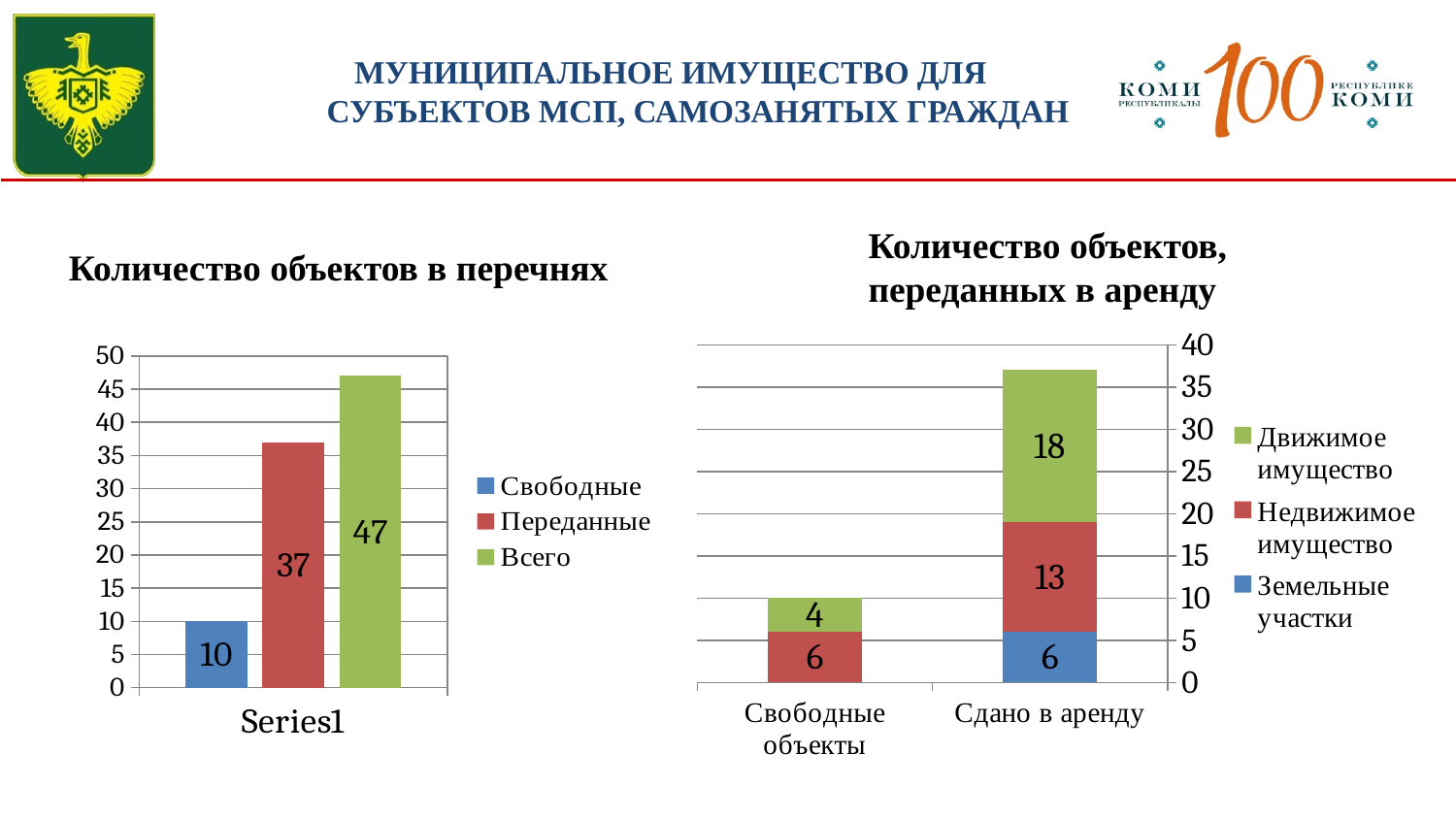
What kind of chart is 'Количество объектов в перечнях'? Bar chart In the chart 'Количество объектов в перечнях', how many series does the legend list? 3 In the chart 'Количество объектов в перечнях', what is the value for Свободные? 10 In the chart 'Количество объектов, переданных в аренду', what is the total of the stacked bar for Сдано в аренду? 37 In the chart 'Количество объектов в перечнях', what is the value for Переданные? 37 In the chart 'Количество объектов, переданных в аренду', how many categories are shown on the x axis? 2 In the chart 'Количество объектов, переданных в аренду', what is the total of the stacked bar for Свободные объекты? 10 In the chart 'Количество объектов в перечнях', which series has the highest value? Всего In the chart 'Количество объектов, переданных в аренду', which is larger for Сдано в аренду: Недвижимое имущество or Земельные участки? Недвижимое имущество In the chart 'Количество объектов в перечнях', what is the difference between Всего and Переданные? 10 In the chart 'Количество объектов, переданных в аренду', what is the value of Недвижимое имущество for Свободные объекты? 6 In the chart 'Количество объектов, переданных в аренду', what is the value of Движимое имущество for Сдано в аренду? 18